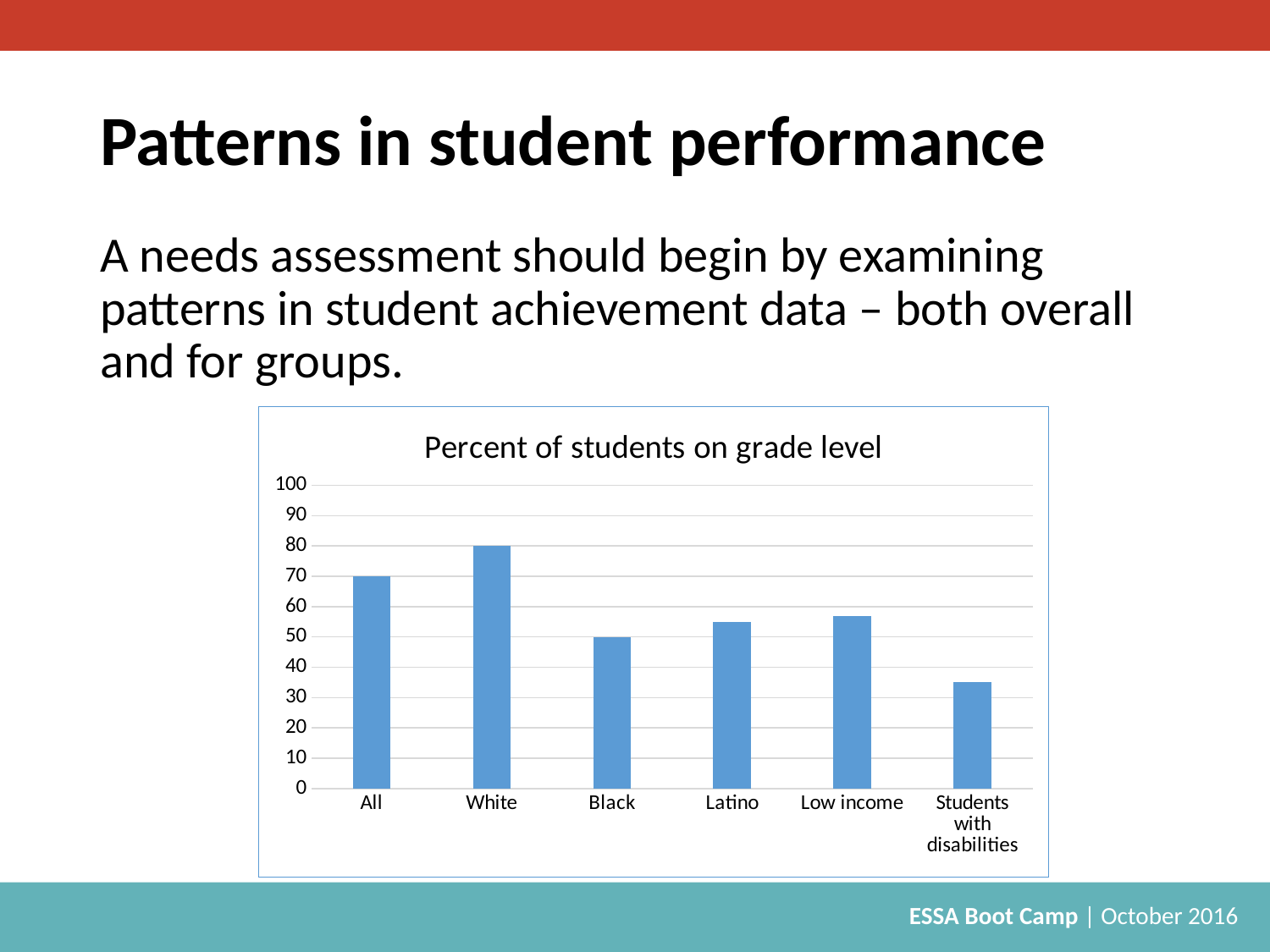
What is the value for All in the chart? 70 How many categories are shown on the x axis of the chart? 6 What is the value for White in the chart? 80 What is the value for Black in the chart? 50 What is the difference between the values for White and Black? 30 What type of chart is shown on the slide? bar chart Which is larger, the value for Black or the value for Low income? Low income Which category has the lowest value in the chart? Students with disabilities Is the value for Students with disabilities greater or less than 40? less What is the title of the chart? Percent of students on grade level Is the value for Low income greater or less than 50? greater Which category has the highest value in the chart? White